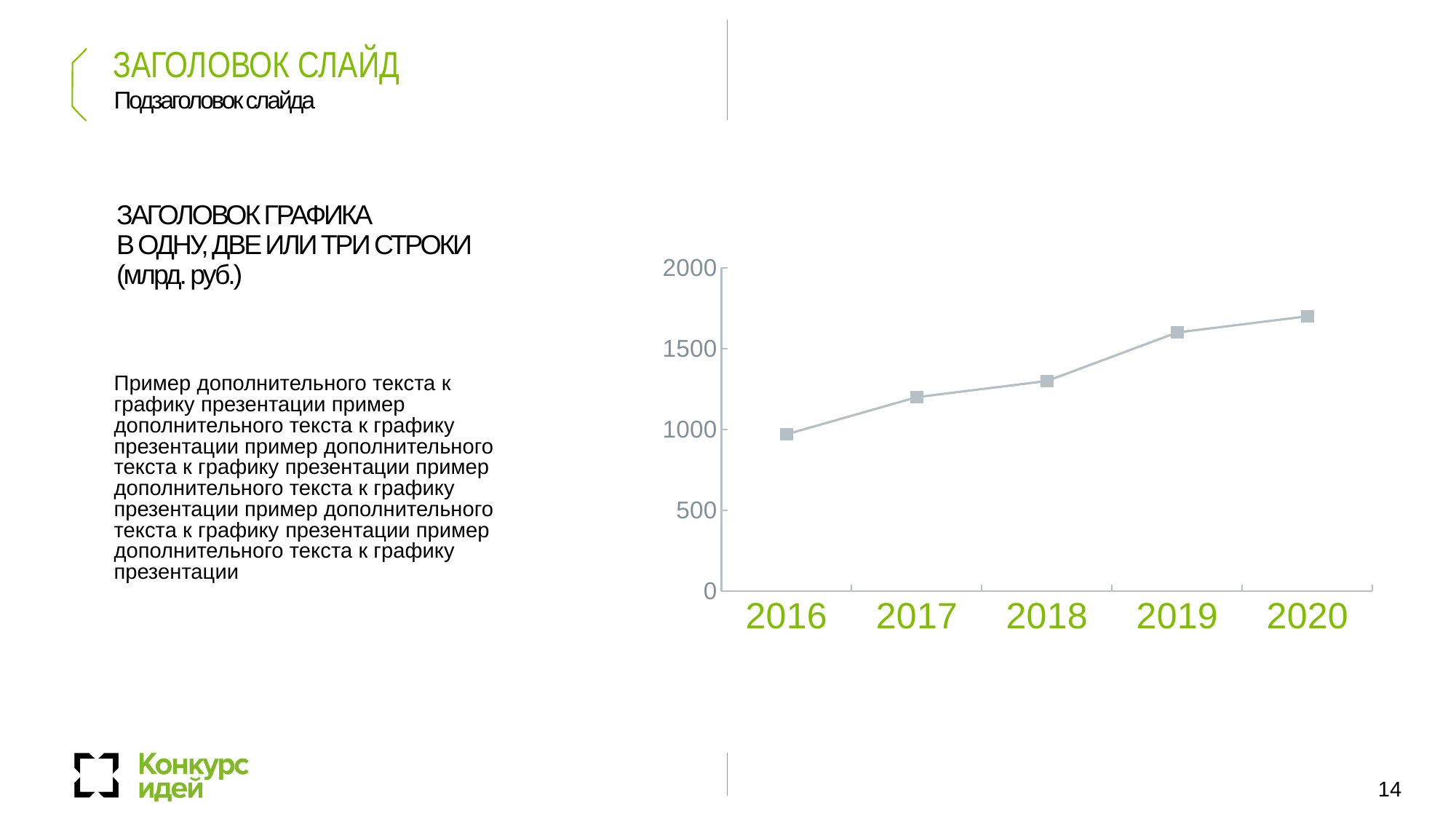
Is the value for 2019 greater or less than 1500? greater Do the values rise or fall from 2016 to 2020? rise Which year has the highest value on the chart? 2020 Is the value for 2020 greater or less than 2000? less Which year has the lowest value on the chart? 2016 Which is larger, the value for 2019 or the value for 2017? 2019 What kind of chart is shown on the slide? line chart How many data points are plotted on the line chart? 5 What unit is given in parentheses in the chart title? млрд. руб. Which is larger, the value for 2016 or the value for 2018? 2018 Is the value for 2018 greater or less than 1500? less